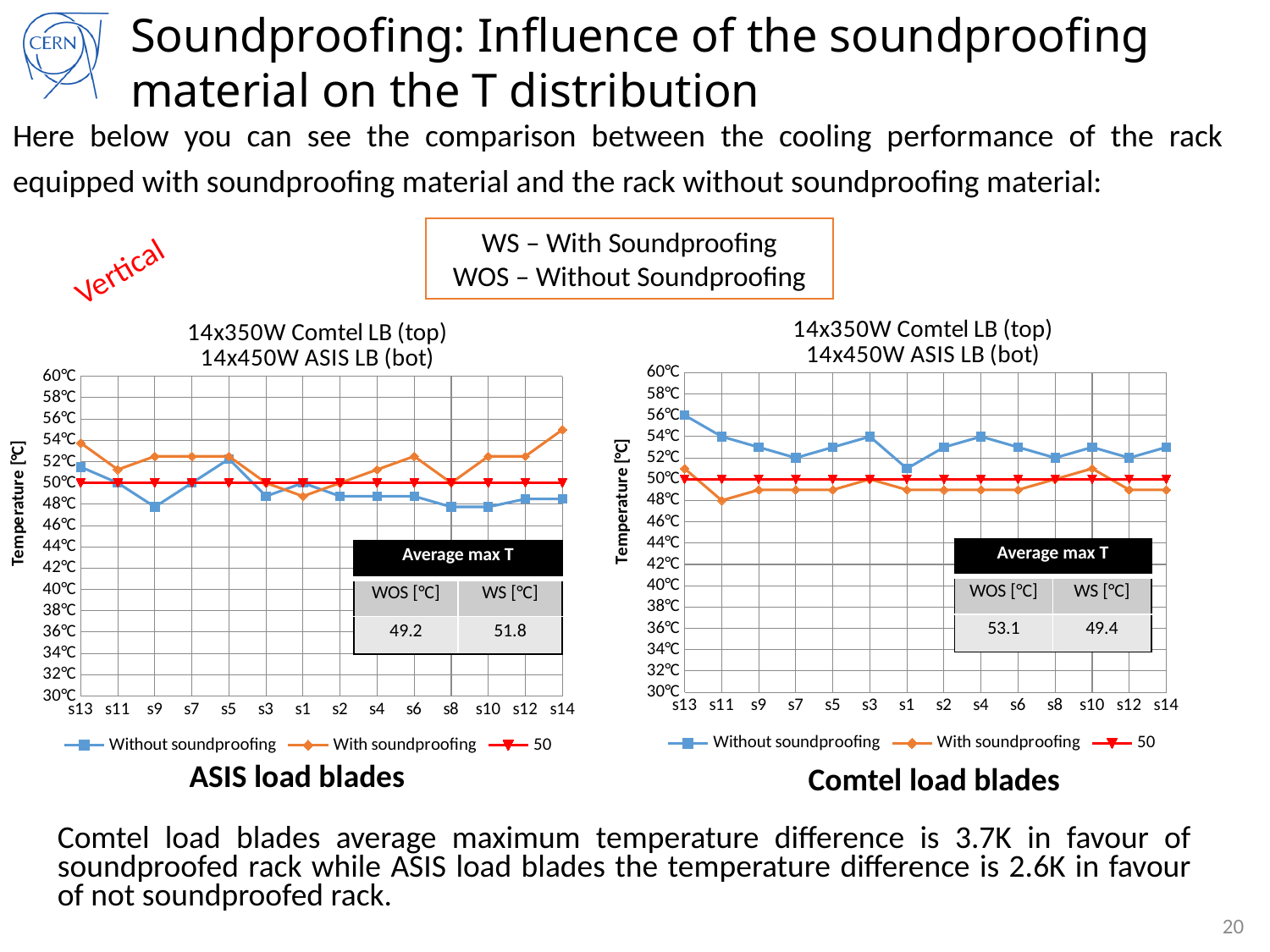
In the Comtel load blades chart, what is the Average max T for WOS [°C]? 53.1 In the Comtel load blades chart, what is the difference between the Average max T for WOS and WS? 3.7 In the ASIS load blades chart, what is the Average max T for WOS [°C]? 49.2 How many series does the legend of the Comtel load blades chart list? 3 What type of chart is the ASIS load blades chart on the left? line chart In the Comtel load blades chart, at s13 which series has the higher temperature, Without soundproofing or With soundproofing? Without soundproofing In the Comtel load blades chart, what is the Average max T for WS [°C]? 49.4 In the ASIS load blades chart, what is the Average max T for WS [°C]? 51.8 In the Comtel load blades chart, at which slot does the Without soundproofing series reach its highest temperature? s13 In the Comtel load blades chart, is the Without soundproofing value at s13 greater or less than 54°C? greater In the ASIS load blades chart, is the Without soundproofing value at s9 greater or less than 50°C? less How many x-axis categories (slots) are plotted in the ASIS load blades chart? 14